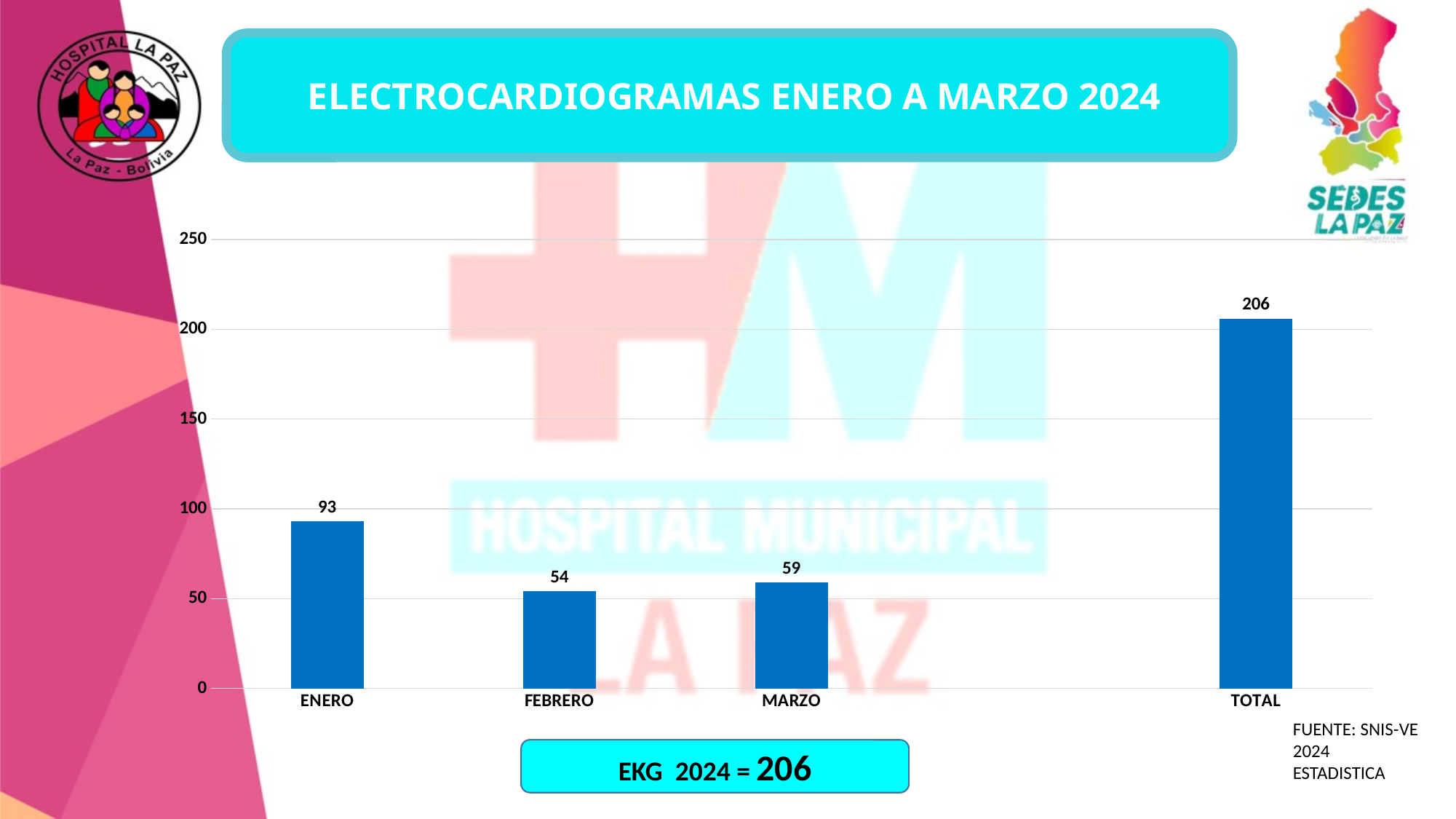
What is the title of the chart? ELECTROCARDIOGRAMAS ENERO A MARZO 2024 Which month (ENERO, FEBRERO or MARZO) has the highest value? ENERO What kind of chart is shown on the slide? bar chart What is the value for MARZO? 59 What is the value for FEBRERO? 54 What is the value for TOTAL? 206 What is the value for ENERO? 93 Which category has the lowest value? FEBRERO What is the difference between the values for ENERO and FEBRERO? 39 Is the value for TOTAL greater or less than 200? greater Which is larger, the value for MARZO or the value for FEBRERO? MARZO How many categories are shown on the x axis? 4